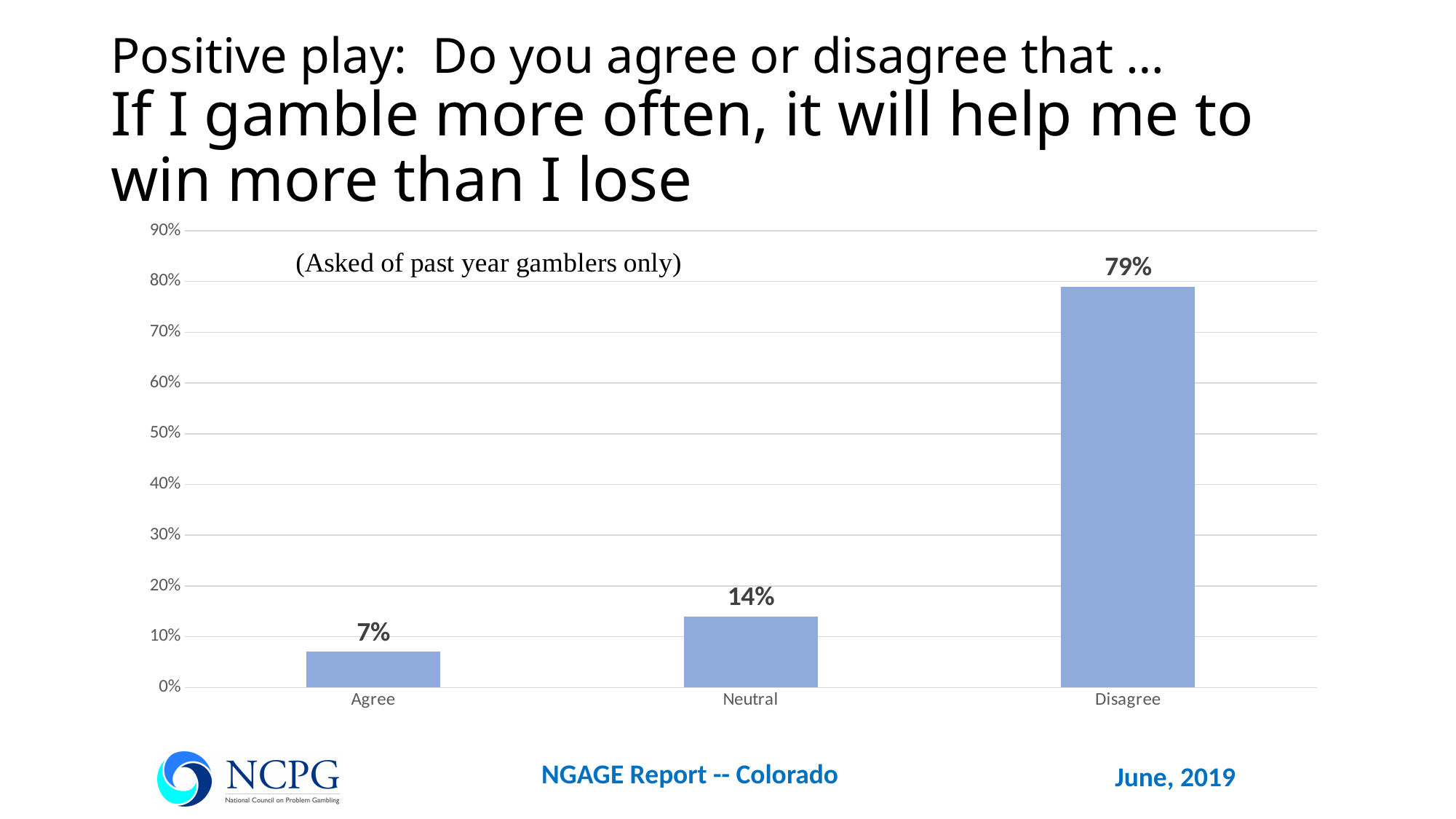
How many response categories are shown on the x axis? 3 What is the difference between the Neutral and Agree values? 7% What kind of chart is shown on the slide? Bar chart What percentage of respondents chose Agree? 7% What percentage of respondents chose Disagree? 79% Which response category has the lowest value? Agree Which response category has the highest value? Disagree Which is larger, the value for Neutral or the value for Agree? Neutral What is the difference between the Disagree and Neutral values? 65% Is the value for Disagree greater or less than 70%? greater What percentage of respondents chose Neutral? 14% Do the values rise or fall moving from Agree to Disagree along the x axis? Rise